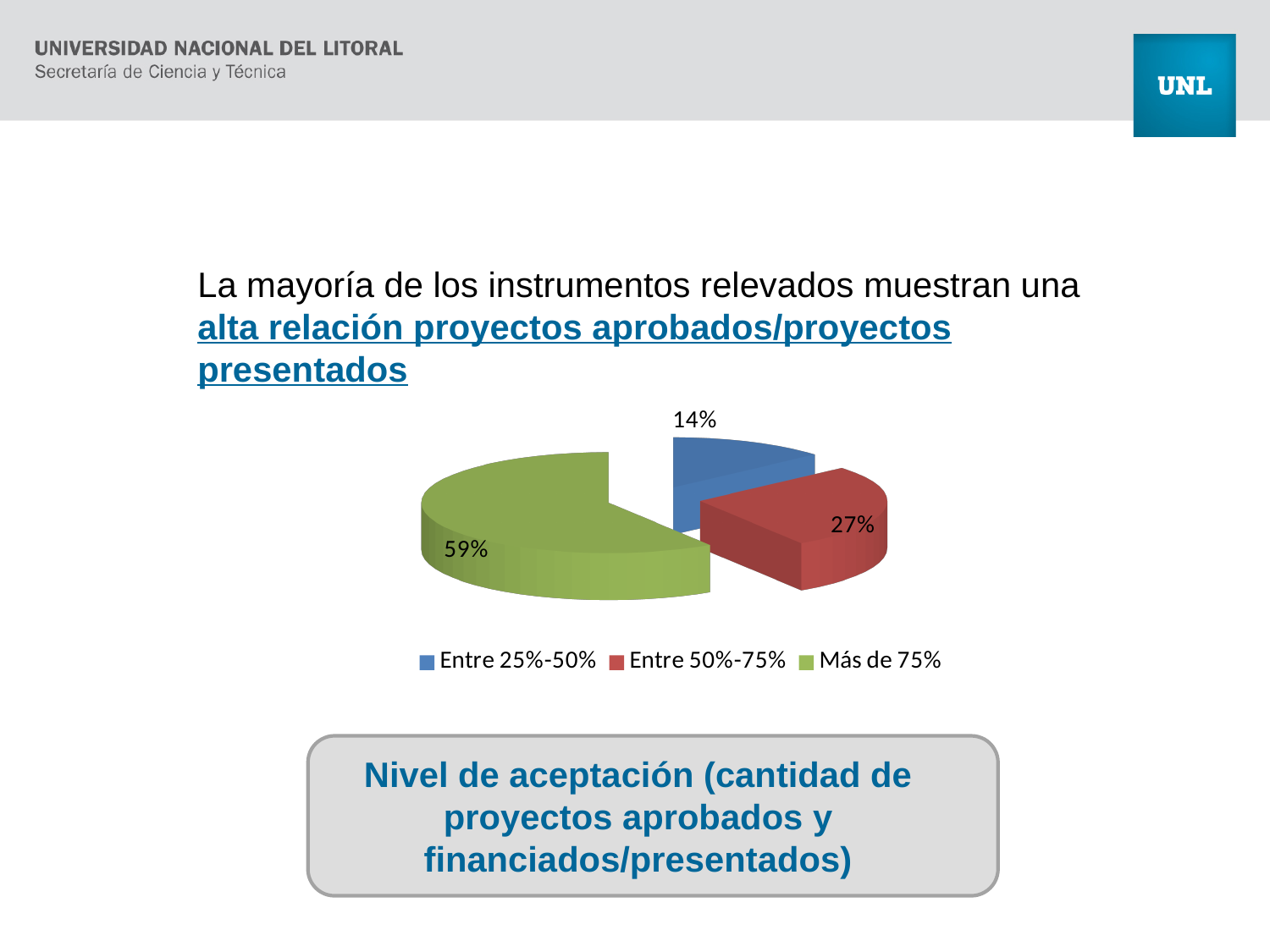
How many entries does the legend of the pie chart list? 3 What share of the pie does the 'Más de 75%' slice represent? 59% What is the difference in percentage points between the 'Entre 50%-75%' slice and the 'Entre 25%-50%' slice? 13 What share of the pie does the 'Entre 25%-50%' slice represent? 14% What share of the pie does the 'Entre 50%-75%' slice represent? 27% Which category has the largest slice of the pie? Más de 75% How many slices does the pie chart have? 3 What kind of chart is shown on the slide? pie chart What colour is the 'Más de 75%' slice in the pie chart? green What is the difference in percentage points between the 'Más de 75%' slice and the 'Entre 50%-75%' slice? 32 Which is larger, the 'Entre 50%-75%' slice or the 'Entre 25%-50%' slice? Entre 50%-75% Which category has the smallest slice of the pie? Entre 25%-50%